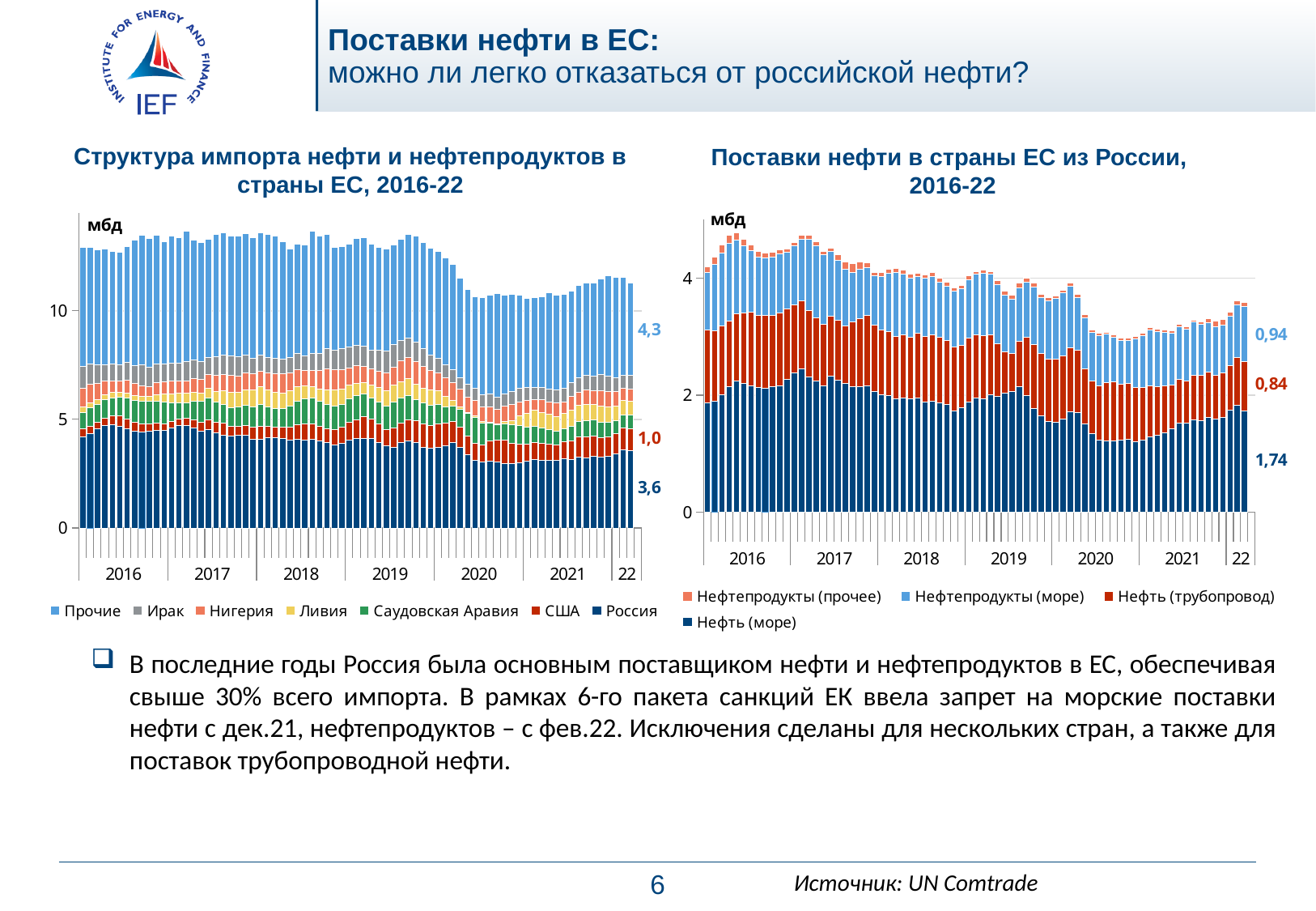
What kind of chart is the left chart, 'Структура импорта нефти и нефтепродуктов в страны ЕС, 2016-22'? Stacked bar chart How many series does the legend of the right chart 'Поставки нефти в страны ЕС из России, 2016-22' list? 4 How many series does the legend of the left chart 'Структура импорта нефти и нефтепродуктов в страны ЕС, 2016-22' list? 7 In the left chart 'Структура импорта нефти и нефтепродуктов в страны ЕС, 2016-22', what value is labelled for США at the end of the series? 1,0 In the left chart 'Структура импорта нефти и нефтепродуктов в страны ЕС, 2016-22', what value is labelled for Прочие at the end of the series? 4,3 In the right chart 'Поставки нефти в страны ЕС из России, 2016-22', do the total bar heights rise or fall from 2016 to 2020? Fall In the right chart 'Поставки нефти в страны ЕС из России, 2016-22', what value is labelled for Нефть (море) at the end of the series? 1,74 In the left chart 'Структура импорта нефти и нефтепродуктов в страны ЕС, 2016-22', what value is labelled for Россия at the end of the series? 3,6 In the left chart 'Структура импорта нефти и нефтепродуктов в страны ЕС, 2016-22', what is the difference between the labelled values for Россия (3,6) and США (1,0)? 2,6 In the right chart 'Поставки нефти в страны ЕС из России, 2016-22', are the total bar heights in 2021 greater or less than 4? less In the right chart 'Поставки нефти в страны ЕС из России, 2016-22', what value is labelled for Нефть (трубопровод) at the end of the series? 0,84 In the right chart 'Поставки нефти в страны ЕС из России, 2016-22', which labelled value is larger: Нефтепродукты (море) or Нефть (трубопровод)? Нефтепродукты (море)